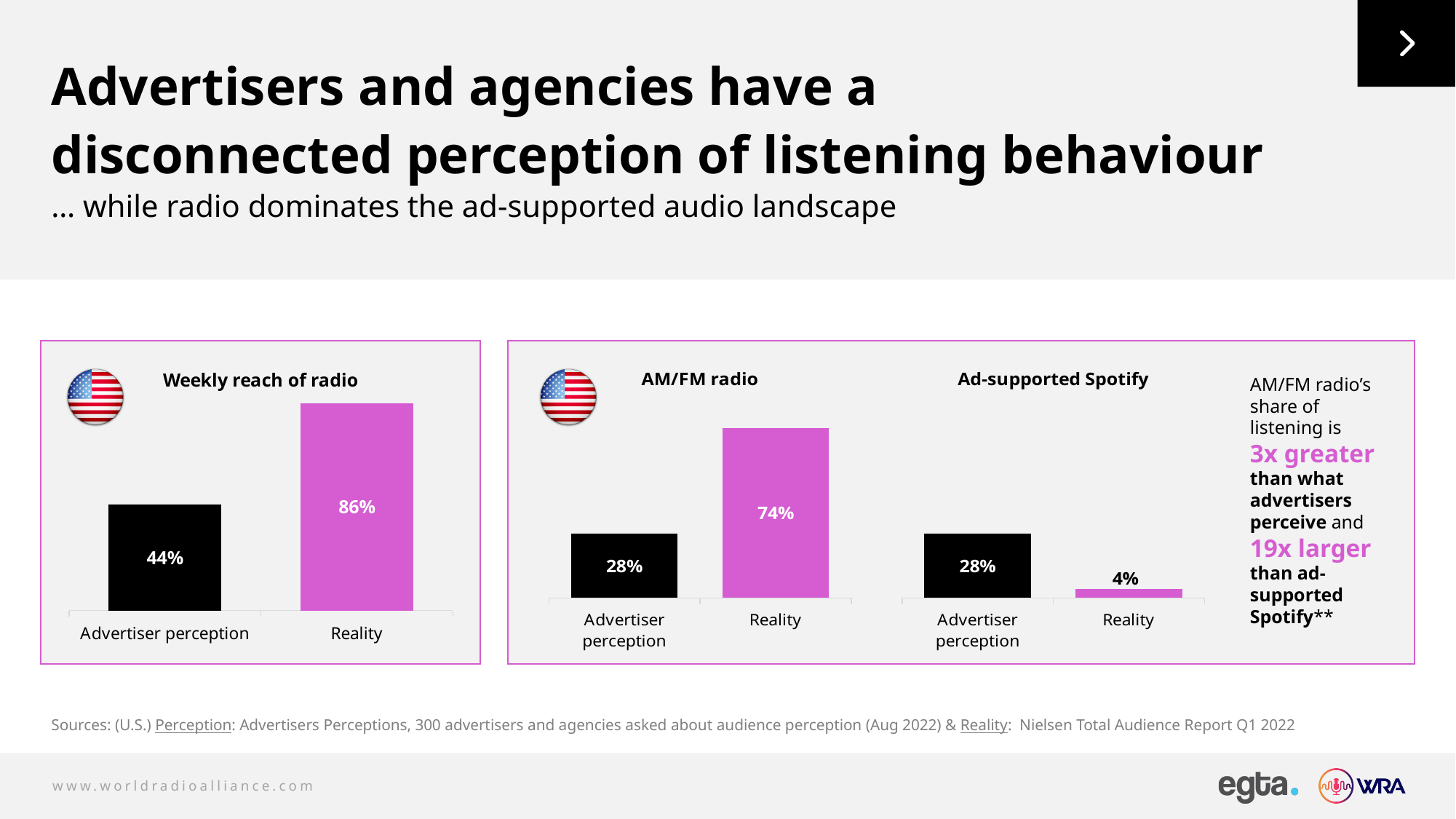
In the 'Ad-supported Spotify' chart, what is the value for Reality? 4% In the 'Weekly reach of radio' chart, what is the value for Advertiser perception? 44% What kind of chart is the 'Weekly reach of radio' chart? Bar chart In the 'AM/FM radio' chart, what is the value for Advertiser perception? 28% In the 'Ad-supported Spotify' chart, which category is lowest? Reality In the 'Ad-supported Spotify' chart, what is the value for Advertiser perception? 28% In the 'Weekly reach of radio' chart, what is the difference between Reality and Advertiser perception? 42% In the 'Ad-supported Spotify' chart, what is the difference between Advertiser perception and Reality? 24% In the 'Weekly reach of radio' chart, what is the value for Reality? 86% In the 'AM/FM radio' chart, what is the value for Reality? 74% How many categories does the 'AM/FM radio' chart show? 2 In the 'AM/FM radio' chart, which category is higher, Advertiser perception or Reality? Reality